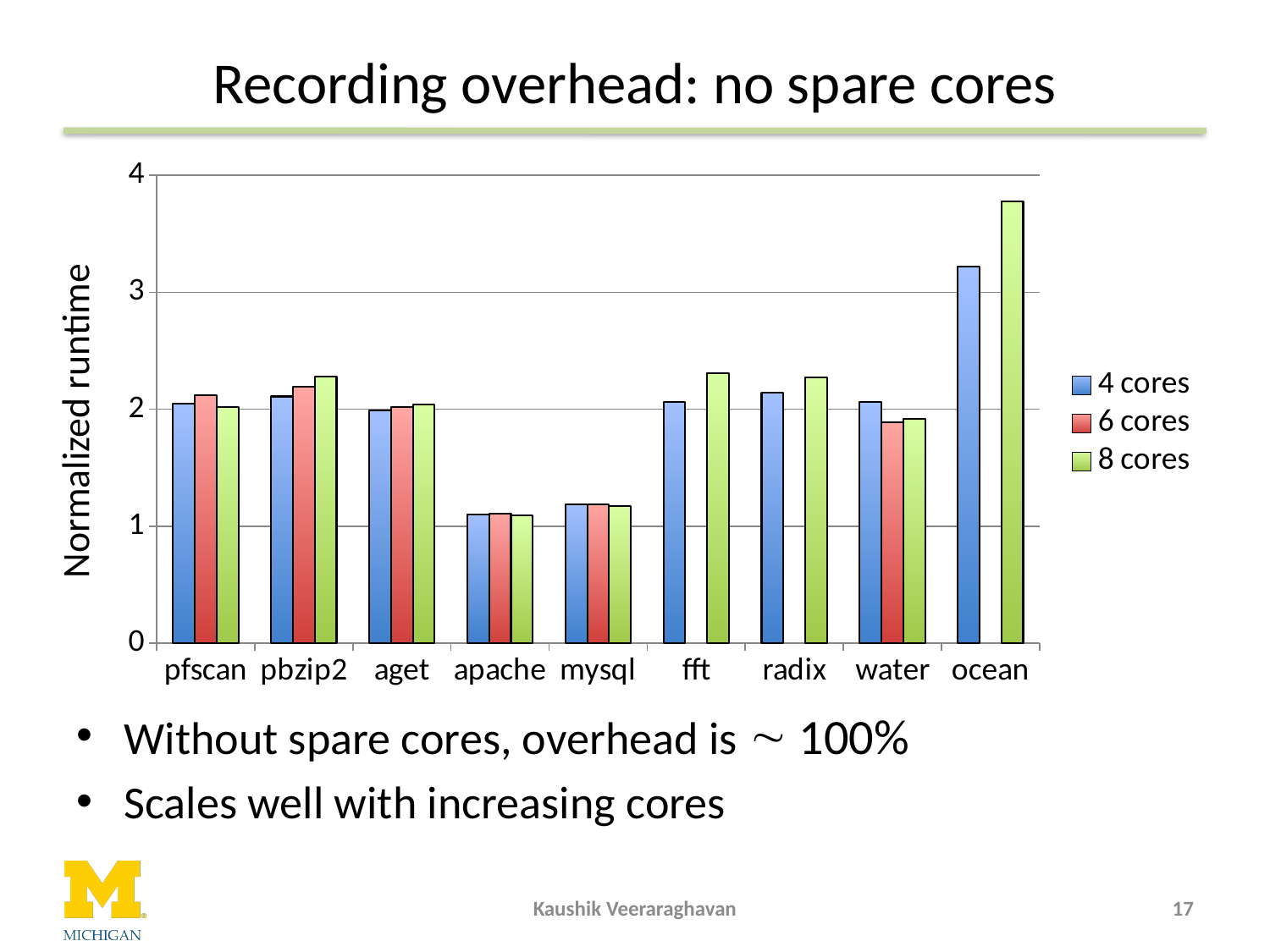
What is the label on the y axis of the chart? Normalized runtime For ocean, which is larger: the 4 cores value or the 8 cores value? 8 cores What kind of chart is shown on the slide? bar chart Which category has the highest 4 cores value? ocean Is the 4 cores value for apache greater or less than 2? less Which category has the highest 8 cores value? ocean Is the 6 cores value for water greater or less than 2? less Is the 8 cores value for ocean greater or less than 3? greater How many series does the legend list? 3 Which is larger: the 4 cores value for apache or the 4 cores value for ocean? ocean How many benchmark categories are shown on the x axis? 9